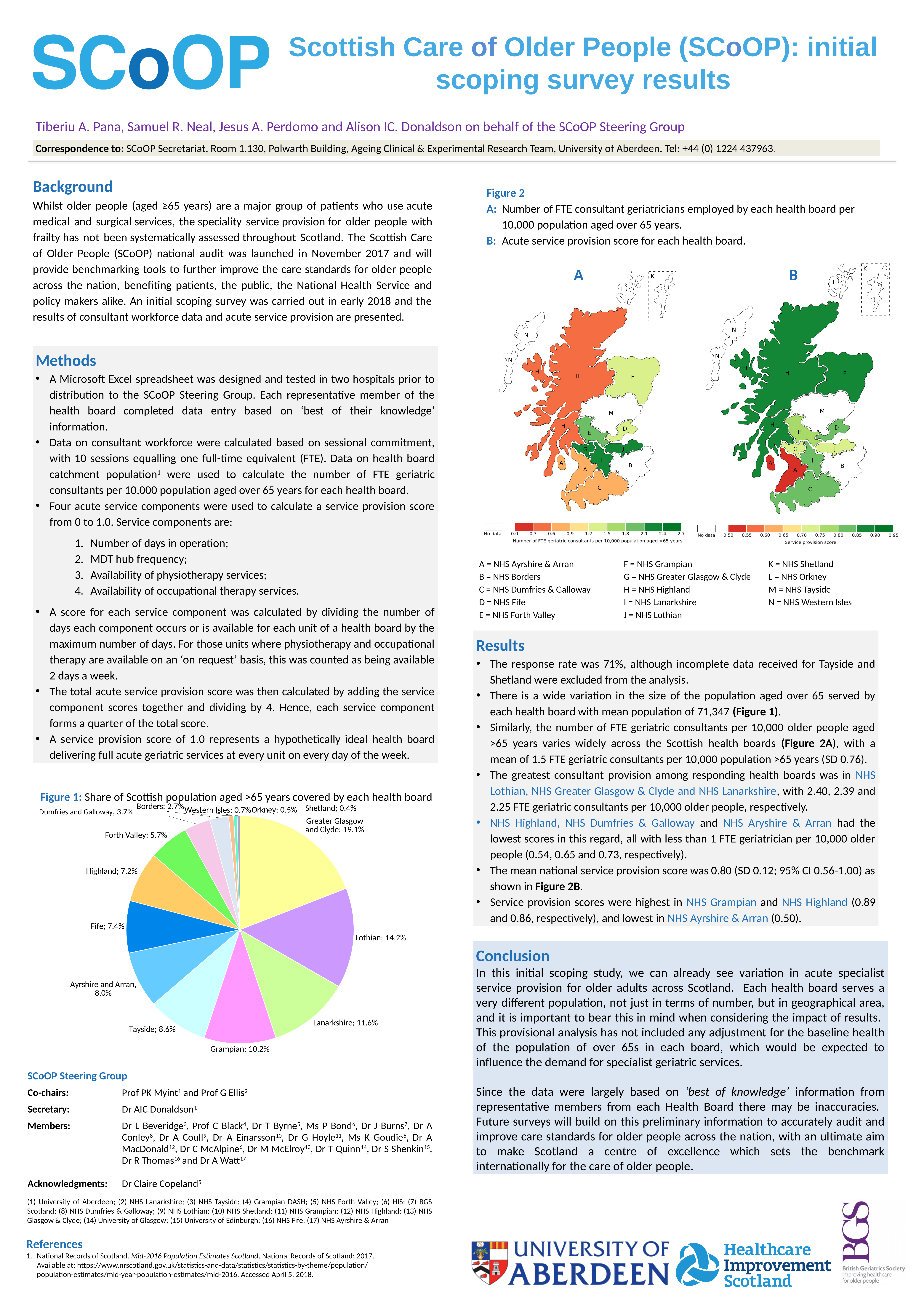
In Figure 1, which health board has the smallest share? Shetland What kind of chart is Figure 1? pie chart In Figure 1, what share is shown for Lothian? 14.2% How many health boards (slices) are shown in the Figure 1 pie chart? 14 In Figure 1, what share of the Scottish population aged >65 years is covered by Greater Glasgow and Clyde? 19.1% What is the title of Figure 1? Share of Scottish population aged >65 years covered by each health board In Figure 1, what share is shown for Forth Valley? 5.7% In Figure 1, which has the larger share, Grampian or Ayrshire and Arran? Grampian In Figure 1, what is the difference in percentage points between the shares for Lothian and Lanarkshire? 2.6 In Figure 1, which has the larger share, Fife or Highland? Fife In Figure 1, what share is shown for Tayside? 8.6% In Figure 1, which health board has the largest share of the population aged >65 years? Greater Glasgow and Clyde